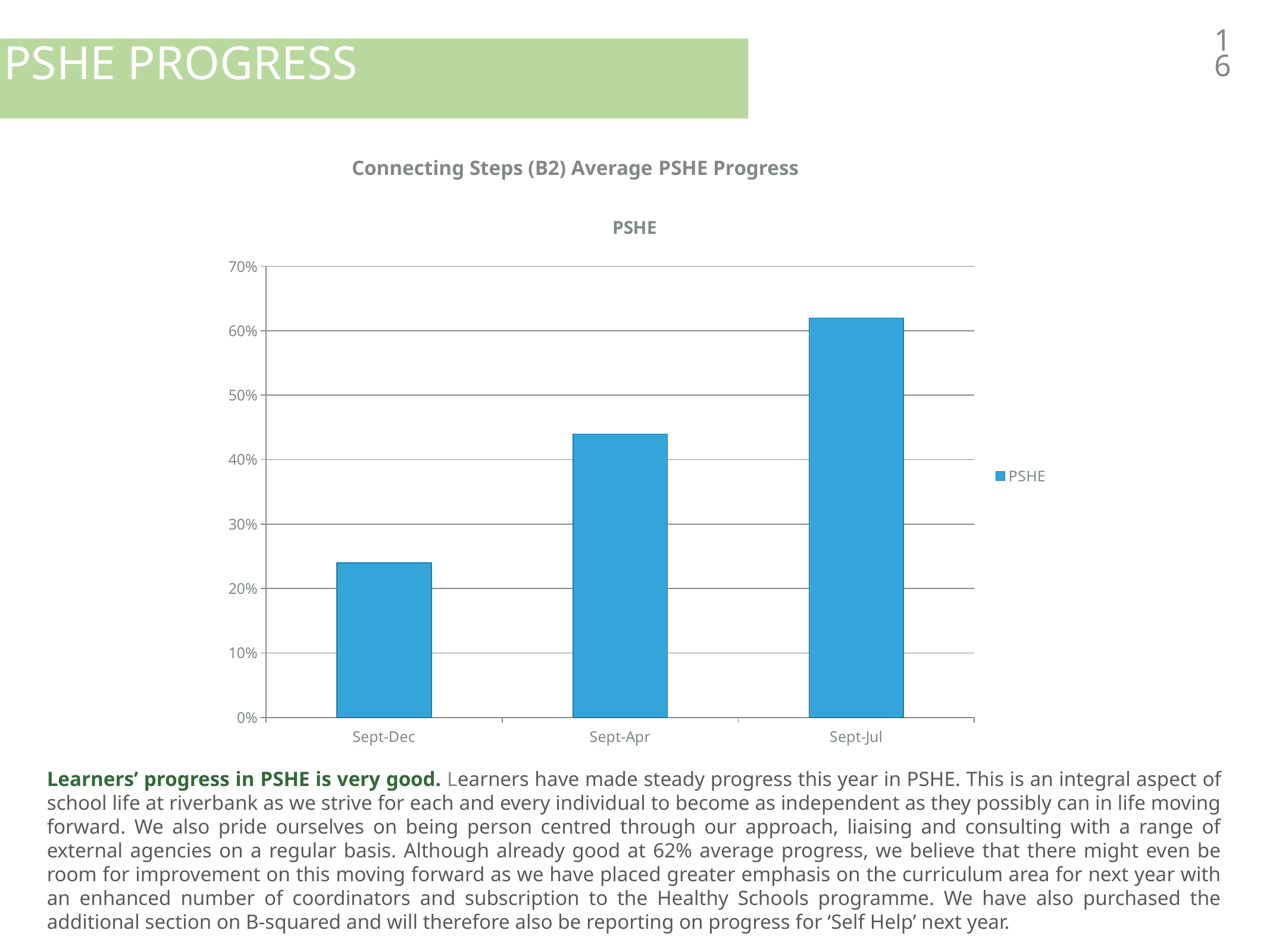
Do the values rise or fall from Sept-Dec to Sept-Jul? rise Is the value for Sept-Apr greater or less than 40%? greater Which is larger, the value for Sept-Apr or the value for Sept-Dec? Sept-Apr How many categories are plotted on the x axis of the chart? 3 What series name appears in the chart's legend? PSHE What is the title of the chart? PSHE Which category has the lowest value in the chart? Sept-Dec Is the value for Sept-Jul greater or less than 60%? greater Is the value for Sept-Dec greater or less than 30%? less How many series does the chart's legend list? 1 What kind of chart is shown on the slide? bar chart Which category has the highest value in the chart? Sept-Jul